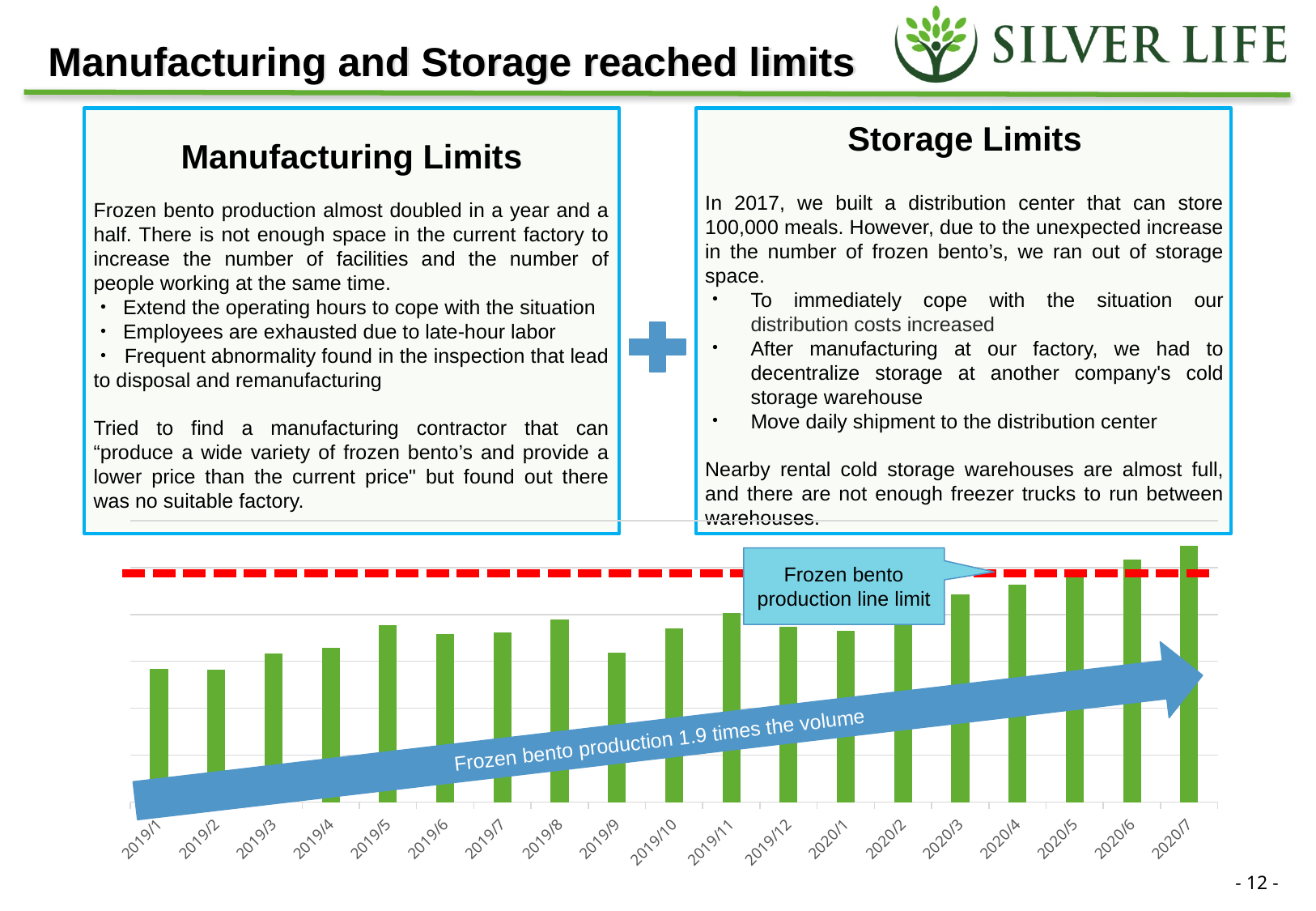
Do the bar values generally rise or fall from 2019/1 to 2020/7? rise Which bar is taller, 2019/8 or 2019/9? 2019/8 Which bar is taller, 2019/2 or 2019/3? 2019/3 Which bar is taller, 2020/6 or 2020/5? 2020/6 Which category has the highest bar in the chart? 2020/7 What is the first category on the x axis of the chart? 2019/1 What kind of chart is shown at the bottom of the slide? bar chart How many categories (months) are shown on the x axis of the bar chart? 19 What is the last category on the x axis of the chart? 2020/7